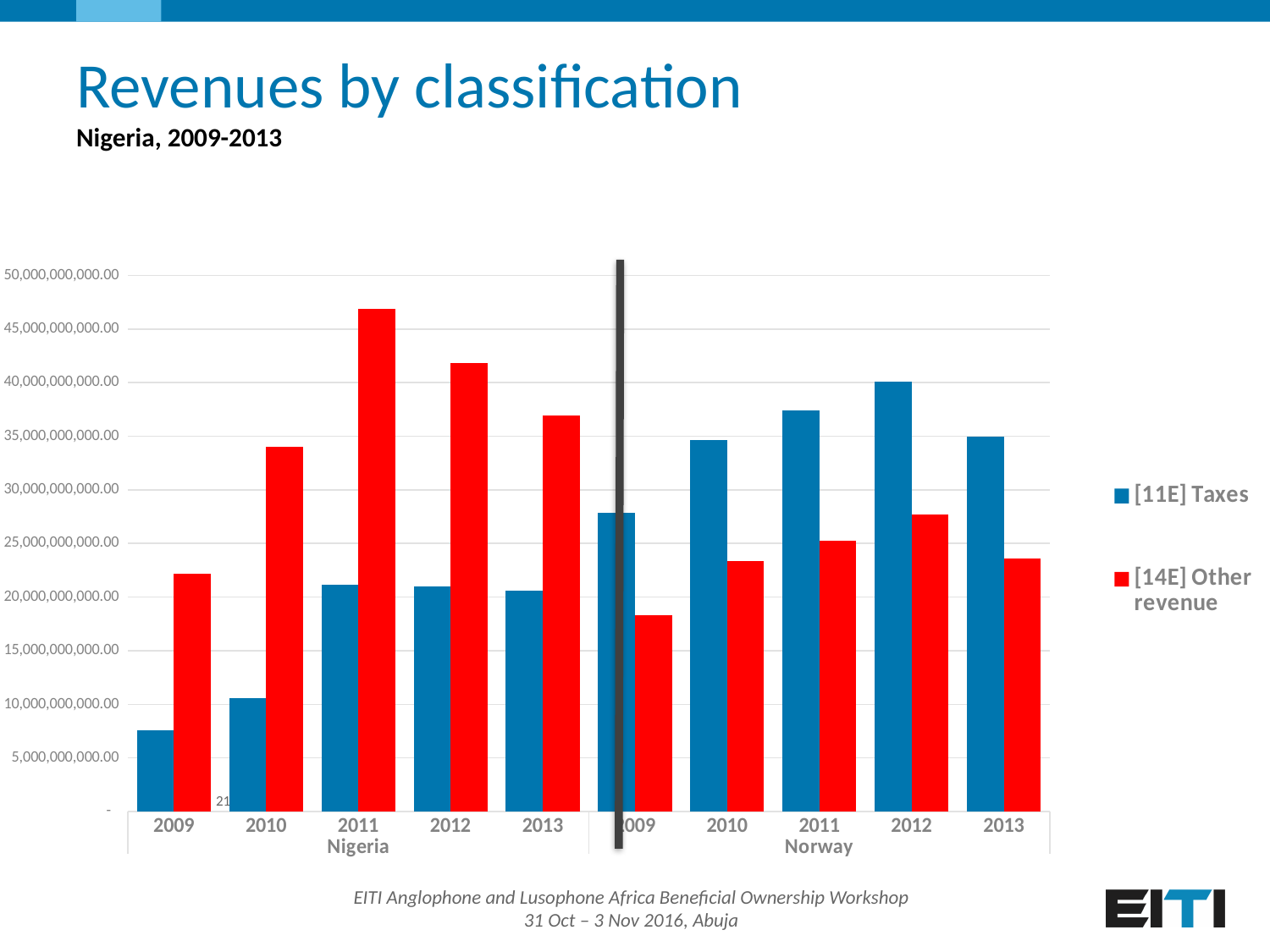
Is the [14E] Other revenue value for Nigeria in 2011 greater or less than 45,000,000,000.00? greater In which year is the [14E] Other revenue bar for Nigeria the highest? 2011 What kind of chart is shown on the slide? Bar chart What are the two legend entries? [11E] Taxes and [14E] Other revenue How many series does the legend list? 2 For Norway in 2009, which is larger: [11E] Taxes or [14E] Other revenue? [11E] Taxes How many years are plotted for each country on the x axis? 5 Is the [14E] Other revenue value for Norway in 2009 greater or less than 20,000,000,000.00? less Is the [11E] Taxes value for Nigeria in 2009 greater or less than 10,000,000,000.00? less In which year is the [11E] Taxes bar for Norway the highest? 2012 Which two countries are compared on the x axis? Nigeria and Norway In which year is the [11E] Taxes bar for Nigeria the lowest? 2009